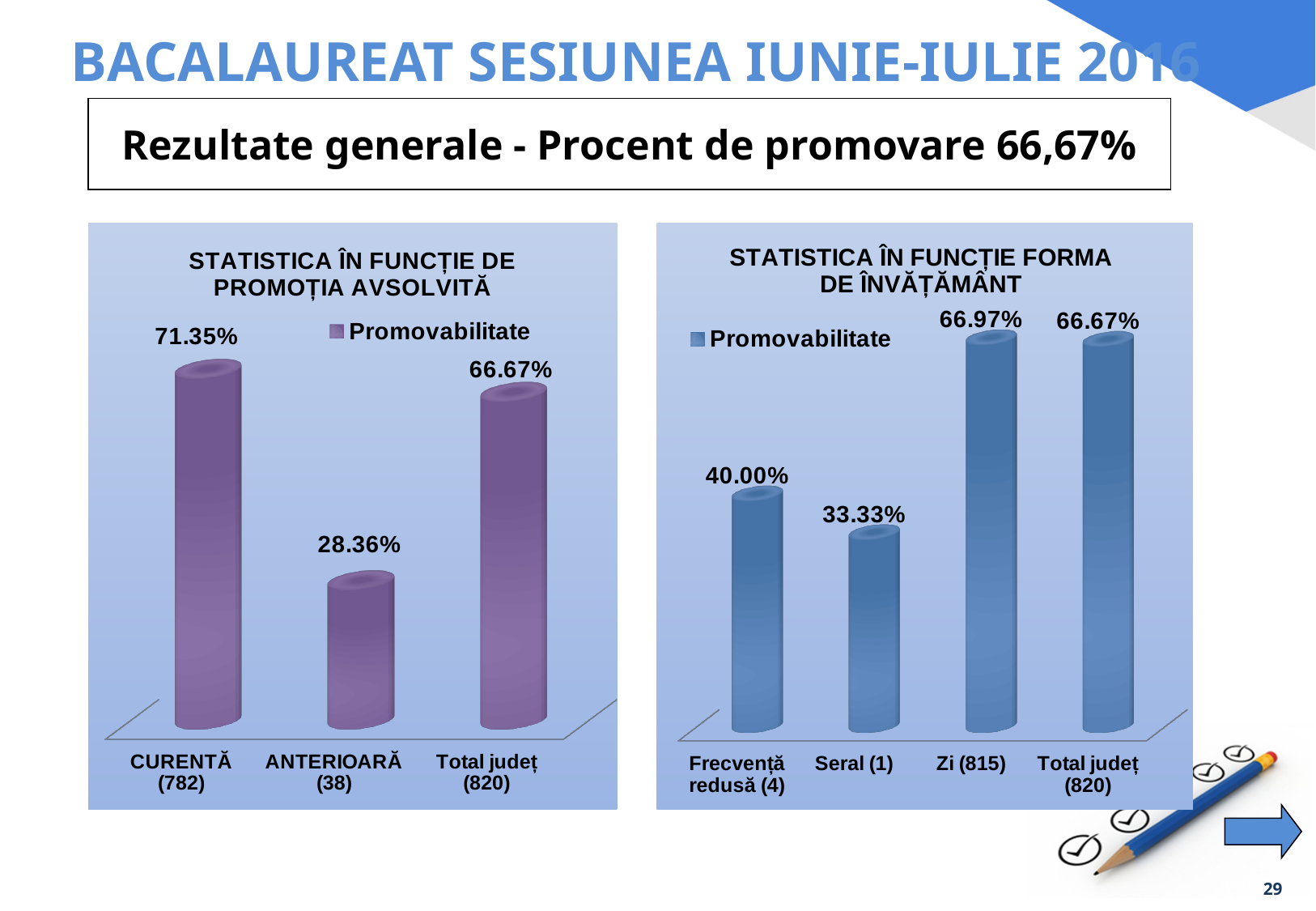
In the right chart (STATISTICA ÎN FUNCȚIE FORMA DE ÎNVĂȚĂMÂNT), what is the value for Zi (815)? 66.97% In the right chart (STATISTICA ÎN FUNCȚIE FORMA DE ÎNVĂȚĂMÂNT), how many categories are shown? 4 In the left chart (STATISTICA ÎN FUNCȚIE DE PROMOȚIA AVSOLVITĂ), how many categories are shown? 3 In the left chart (STATISTICA ÎN FUNCȚIE DE PROMOȚIA AVSOLVITĂ), which category has the highest value? CURENTĂ (782) In the right chart (STATISTICA ÎN FUNCȚIE FORMA DE ÎNVĂȚĂMÂNT), which is larger, the value for Frecvență redusă (4) or Seral (1)? Frecvență redusă (4) In the right chart (STATISTICA ÎN FUNCȚIE FORMA DE ÎNVĂȚĂMÂNT), what is the value for Seral (1)? 33.33% In the left chart (STATISTICA ÎN FUNCȚIE DE PROMOȚIA AVSOLVITĂ), what is the value for CURENTĂ (782)? 71.35% In the right chart (STATISTICA ÎN FUNCȚIE FORMA DE ÎNVĂȚĂMÂNT), which category has the lowest value? Seral (1) In the left chart (STATISTICA ÎN FUNCȚIE DE PROMOȚIA AVSOLVITĂ), what is the value for ANTERIOARĂ (38)? 28.36% In the left chart (STATISTICA ÎN FUNCȚIE DE PROMOȚIA AVSOLVITĂ), what is the difference between the values for CURENTĂ (782) and ANTERIOARĂ (38)? 42.99% What kind of chart is the right chart (STATISTICA ÎN FUNCȚIE FORMA DE ÎNVĂȚĂMÂNT)? Bar chart In the left chart (STATISTICA ÎN FUNCȚIE DE PROMOȚIA AVSOLVITĂ), which category has the lowest value? ANTERIOARĂ (38)